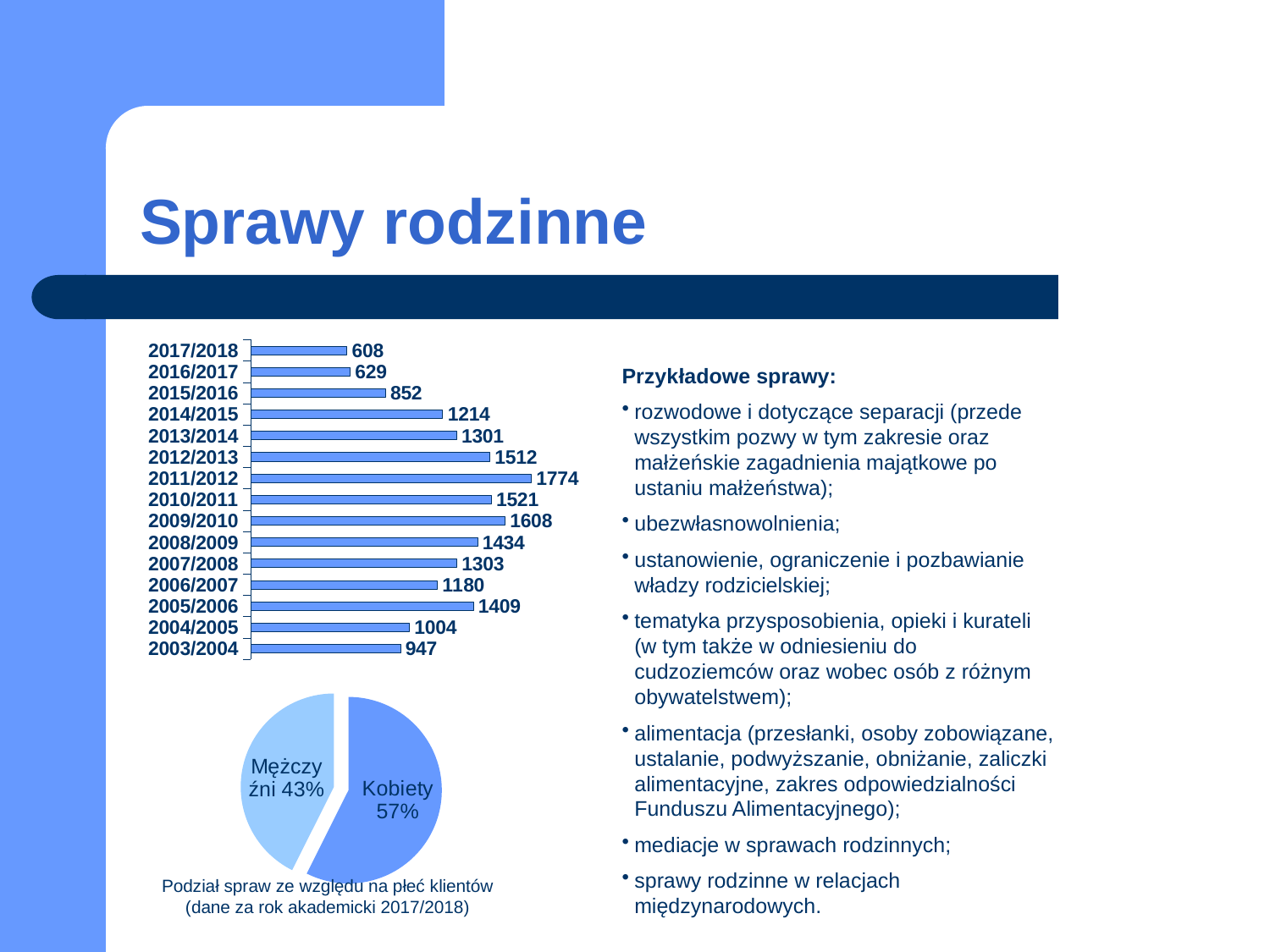
In the bar chart at the top left of the slide, what is the difference between the values for 2011/2012 and 2017/2018? 1166 In the pie chart titled 'Podział spraw ze względu na płeć klientów', what share is Kobiety? 57% In the bar chart at the top left of the slide, which year has the highest value? 2011/2012 In the bar chart at the top left of the slide, how many years are shown? 15 In the pie chart titled 'Podział spraw ze względu na płeć klientów', what share is Mężczyźni? 43% In the bar chart at the top left of the slide, what is the difference between the values for 2015/2016 and 2016/2017? 223 In the bar chart at the top left of the slide, which year has the lowest value? 2017/2018 In the bar chart at the top left of the slide, what is the value for 2011/2012? 1774 In the bar chart at the top left of the slide, what is the value for 2017/2018? 608 What kind of chart is the chart at the bottom left of the slide? pie chart In the bar chart at the top left of the slide, which is larger, the value for 2009/2010 or the value for 2012/2013? 2009/2010 What kind of chart is the chart at the top left of the slide? bar chart